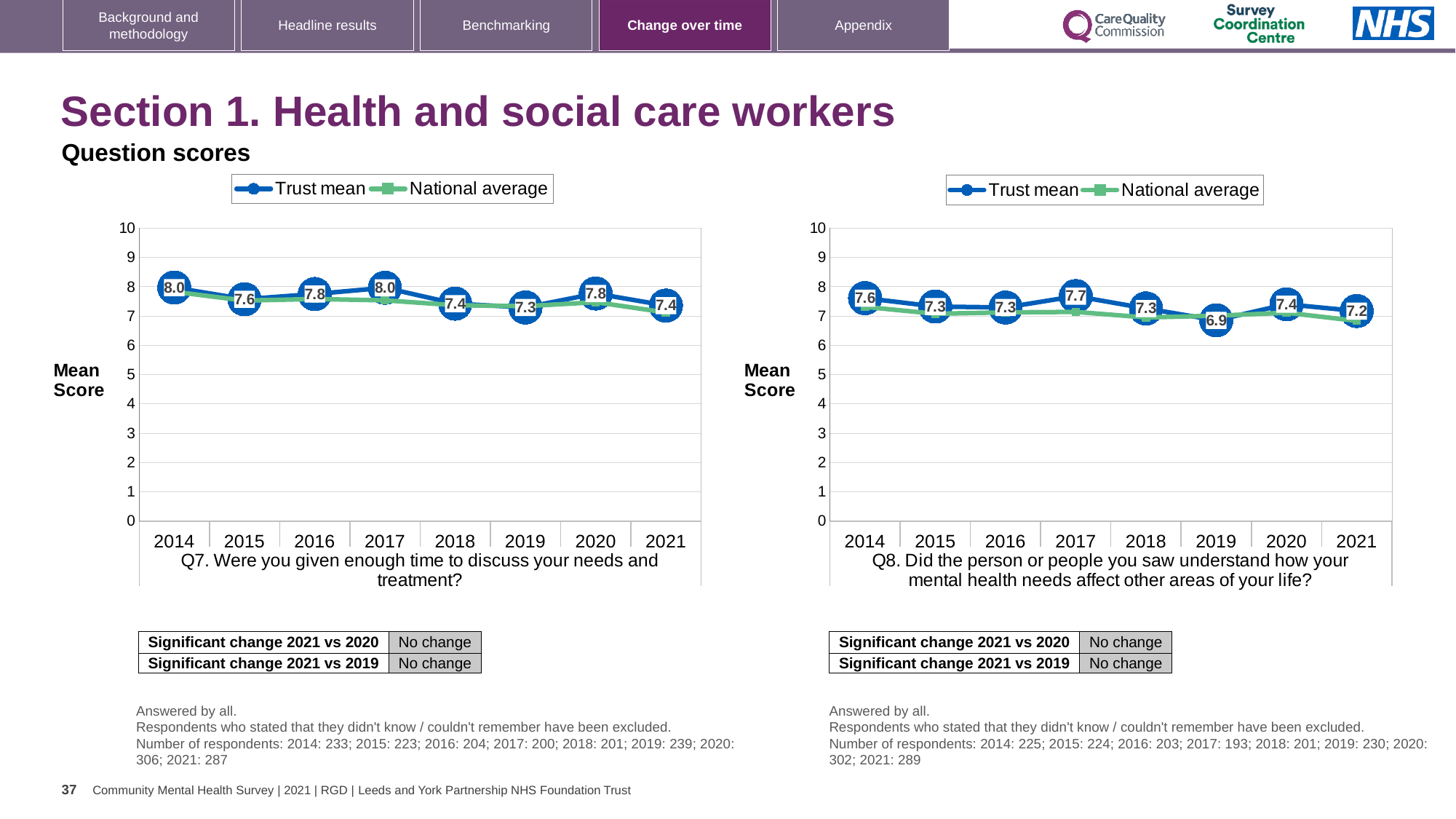
In the Q8 chart (right), which year has the lowest Trust mean score? 2019 In the Q7 chart (left), is the Trust mean score higher in 2020 or in 2021? 2020 How many series does the legend of the Q7 chart (left) list? 2 How many years are plotted on the x axis of the Q8 chart (right)? 8 In the Q7 chart (left), what is the difference between the Trust mean scores for 2017 and 2018? 0.6 In the Q8 chart (right), which year has the highest Trust mean score? 2017 In the Q8 chart (right), what is the difference between the Trust mean scores for 2017 and 2019? 0.8 What type of chart is used for Q8 (right)? Line chart In the Q7 chart (left), what is the Trust mean score for 2014? 8.0 In the Q7 chart (left), what is the Trust mean score for 2021? 7.4 In the Q8 chart (right), what is the Trust mean score for 2019? 6.9 In the Q7 chart (left), which year has the lowest Trust mean score? 2019